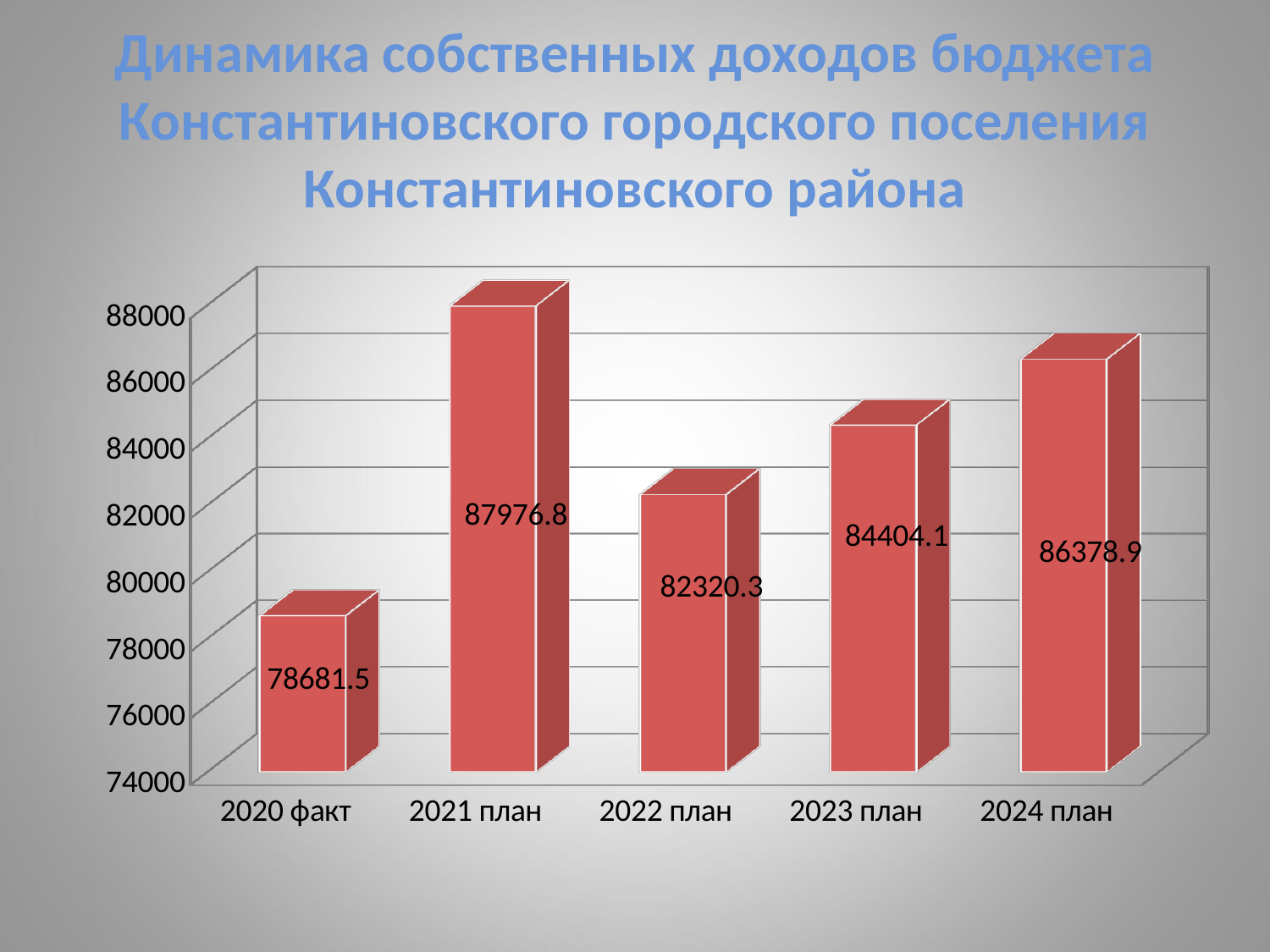
Which category has the lowest value? 2020 факт Which category has the highest value? 2021 план What is the value for 2020 факт? 78681.5 What is the value for 2022 план? 82320.3 Which is larger, the value for 2023 план or the value for 2022 план? 2023 план What kind of chart is shown on the slide? bar chart What is the difference between the values for 2021 план and 2020 факт? 9295.3 What is the difference between the values for 2024 план and 2022 план? 4058.6 What is the value for 2024 план? 86378.9 Is the value for 2020 факт greater or less than 80000? less How many categories are shown on the x axis? 5 What is the value for 2021 план? 87976.8